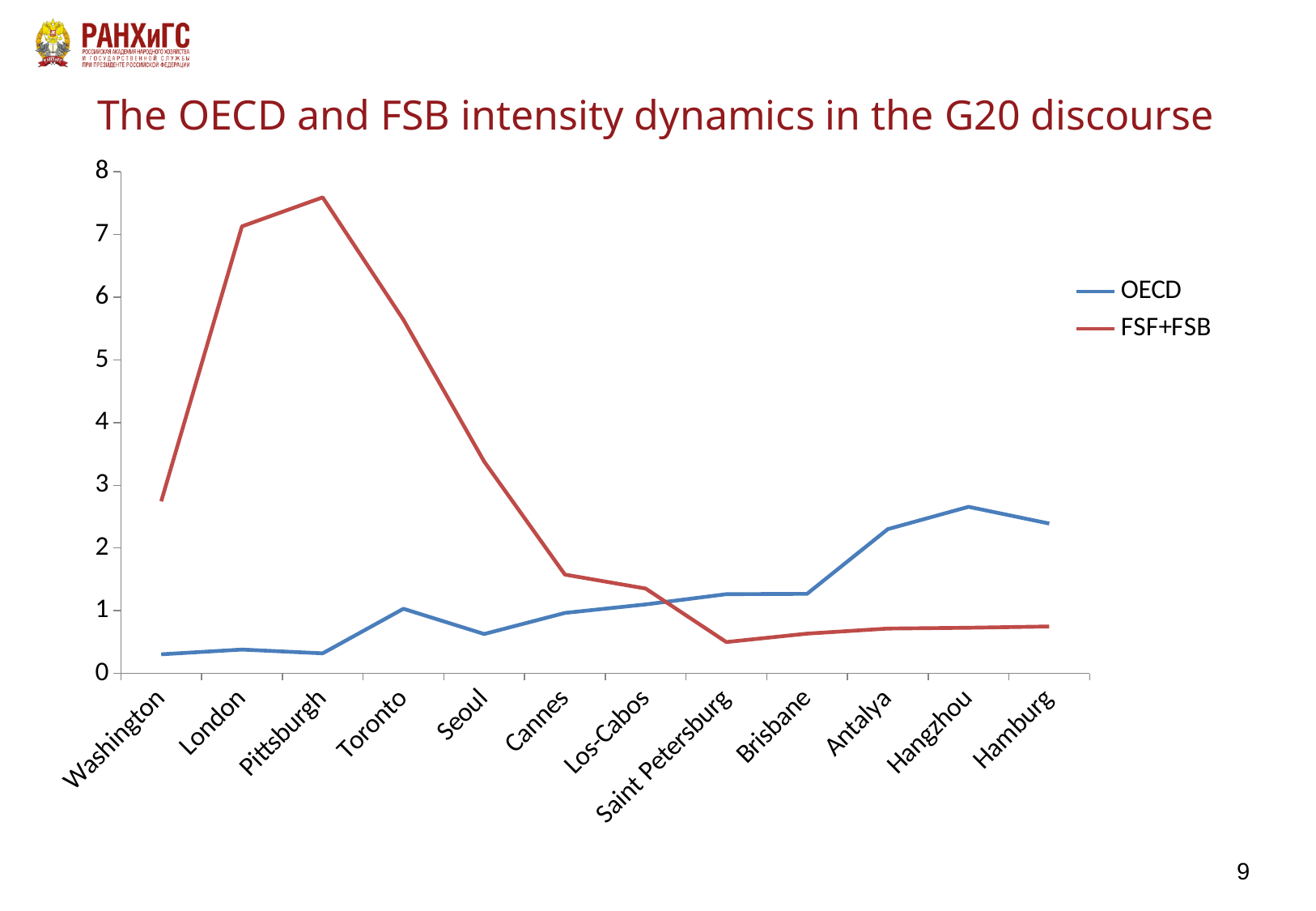
How many series does the legend list? 2 At which summit does the OECD series reach its highest value? Hangzhou At Washington, which series has the larger value, OECD or FSF+FSB? FSF+FSB At Hamburg, which series has the larger value, OECD or FSF+FSB? OECD Is the OECD value for Antalya greater or less than 2? greater Is the FSF+FSB value for Washington greater or less than 3? less Is the FSF+FSB value for Pittsburgh greater or less than 7? greater At which summit does the FSF+FSB series reach its highest value? Pittsburgh How many summit categories are shown along the x axis? 12 At which summit does the FSF+FSB series reach its lowest value? Saint Petersburg Does the FSF+FSB series rise or fall from Pittsburgh to Saint Petersburg? fall What kind of chart is shown on the slide? line chart